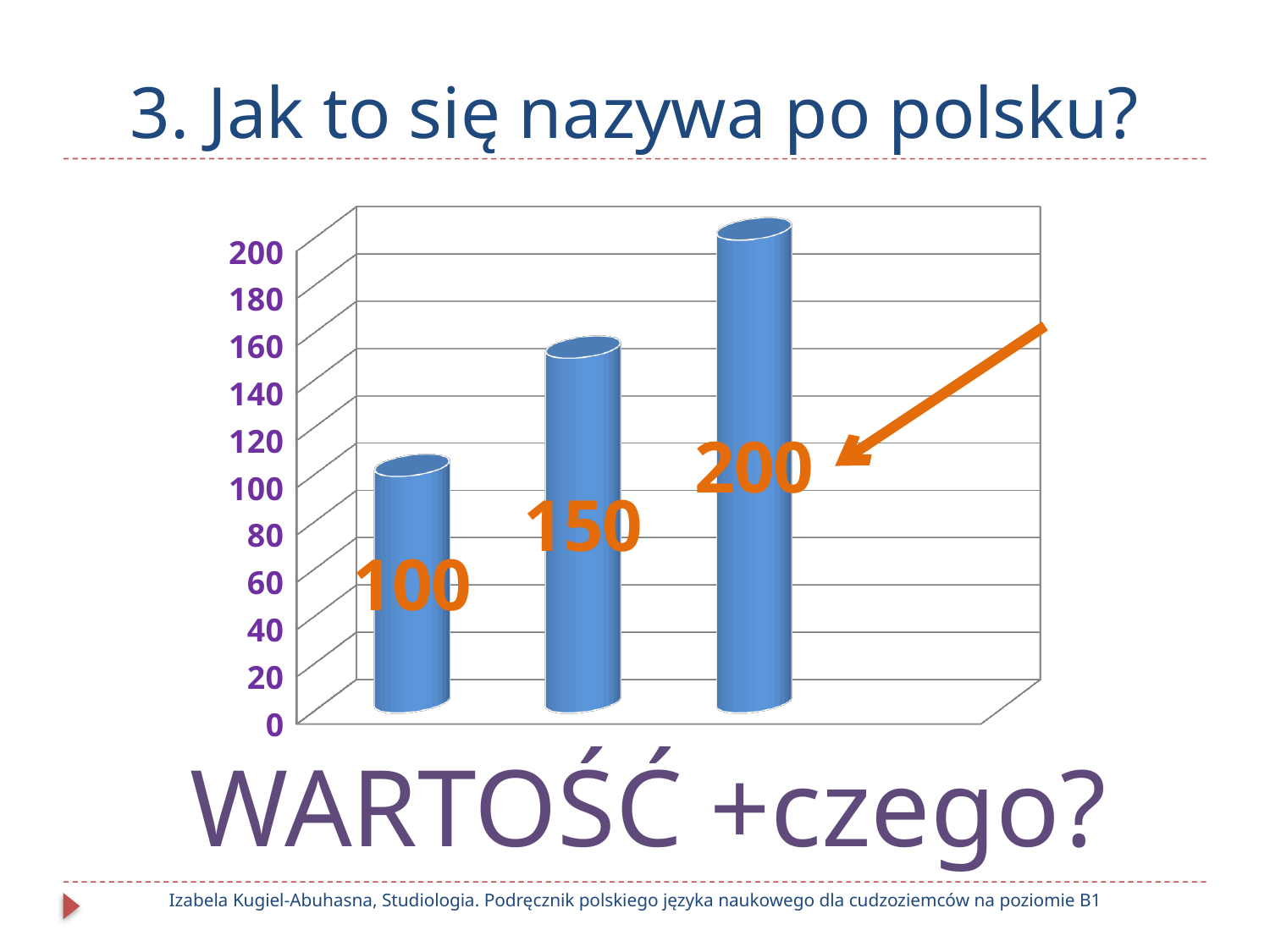
What is the highest value shown on the chart? 200 What is the difference between the tallest bar and the shortest bar? 100 What is the lowest value shown on the chart? 100 What is the value labelled on the rightmost bar? 200 What is the highest tick value shown on the vertical axis? 200 What is the value labelled on the leftmost bar? 100 What is the value labelled on the middle bar? 150 What kind of chart is shown on the slide? bar chart Which is larger, the middle bar or the leftmost bar? the middle bar What is the difference between the middle bar and the leftmost bar? 50 Do the bar values rise or fall from left to right? rise How many bars does the chart show? 3